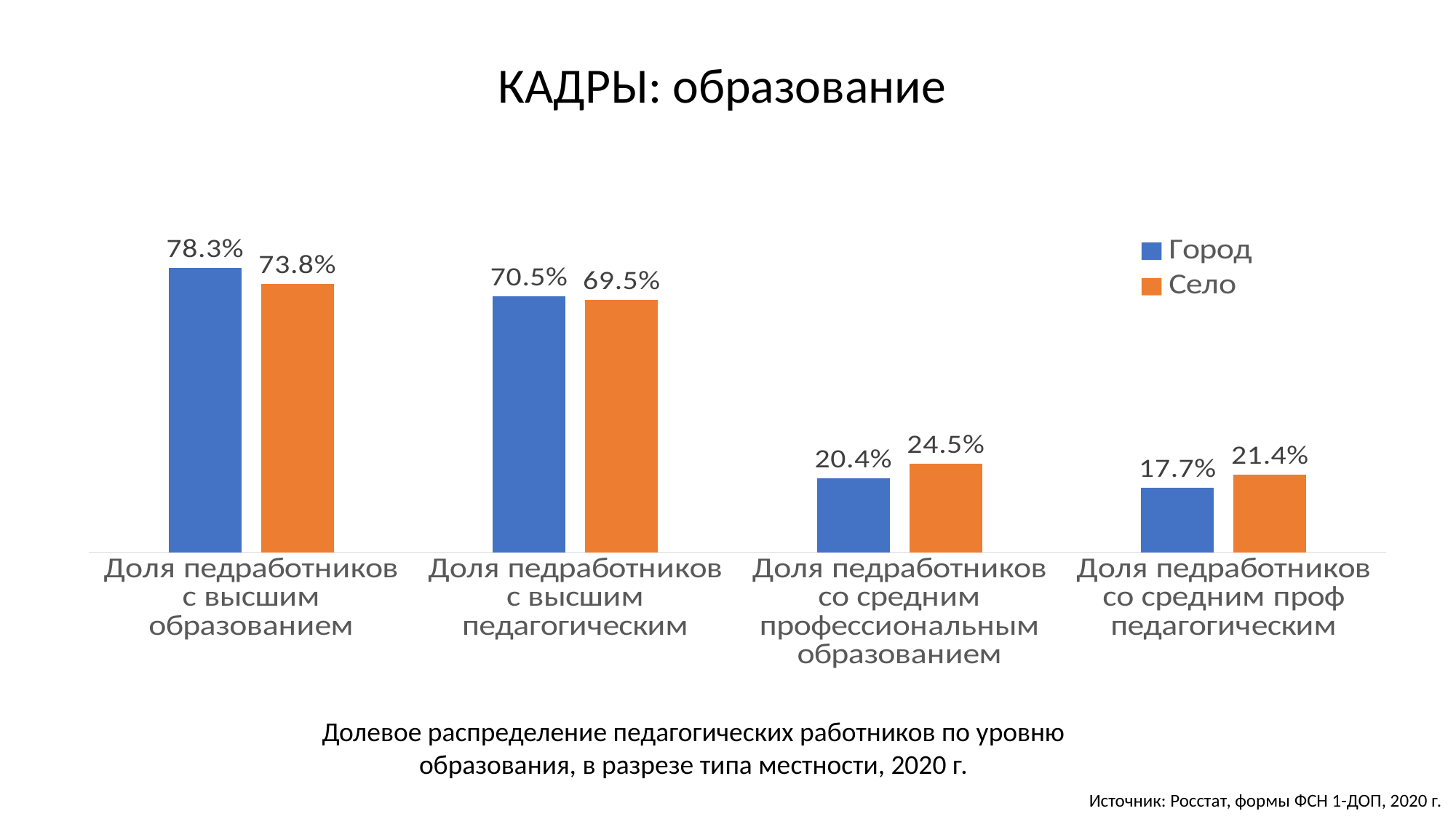
What is the difference between Город and Село in the category 'Доля педработников с высшим образованием'? 4.5% What kind of chart is shown on the slide? Bar chart How many categories are shown on the x axis? 4 What is the value for Город in the category 'Доля педработников со средним проф педагогическим'? 17.7% How many series does the legend list? 2 Which category has the lowest value for Село? Доля педработников со средним проф педагогическим In the category 'Доля педработников со средним проф педагогическим', which is larger: Город or Село? Село What is the value for Город in the category 'Доля педработников с высшим образованием'? 78.3% What is the difference between Село and Город in the category 'Доля педработников со средним профессиональным образованием'? 4.1% What is the value for Село in the category 'Доля педработников со средним профессиональным образованием'? 24.5% What is the value for Село in the category 'Доля педработников с высшим педагогическим'? 69.5% Which category has the highest value for Город? Доля педработников с высшим образованием